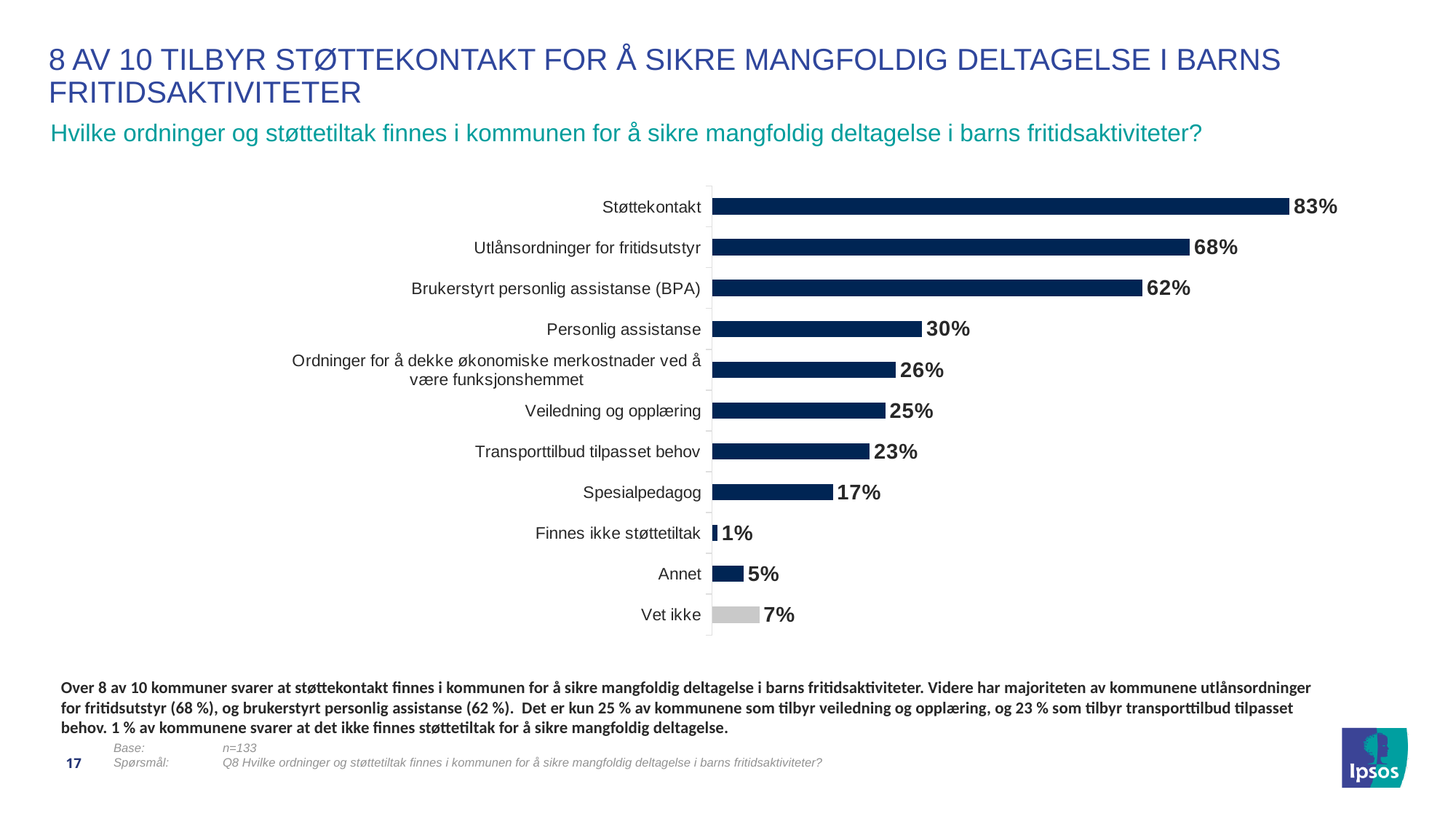
What is the value for Støttekontakt? 83% What kind of chart is shown on the slide? Bar chart What is the value for Utlånsordninger for fritidsutstyr? 68% How many categories are shown in the chart? 11 Which category has the highest value? Støttekontakt What is the difference between the values for Veiledning og opplæring and Annet? 20% What is the difference between the values for Støttekontakt and Brukerstyrt personlig assistanse (BPA)? 21% Which bar is shown in a different colour (grey) from the others? Vet ikke Which category has the lowest value? Finnes ikke støttetiltak Which is larger, the value for Personlig assistanse or the value for Spesialpedagog? Personlig assistanse What is the value for Transporttilbud tilpasset behov? 23% What is the value for Vet ikke? 7%